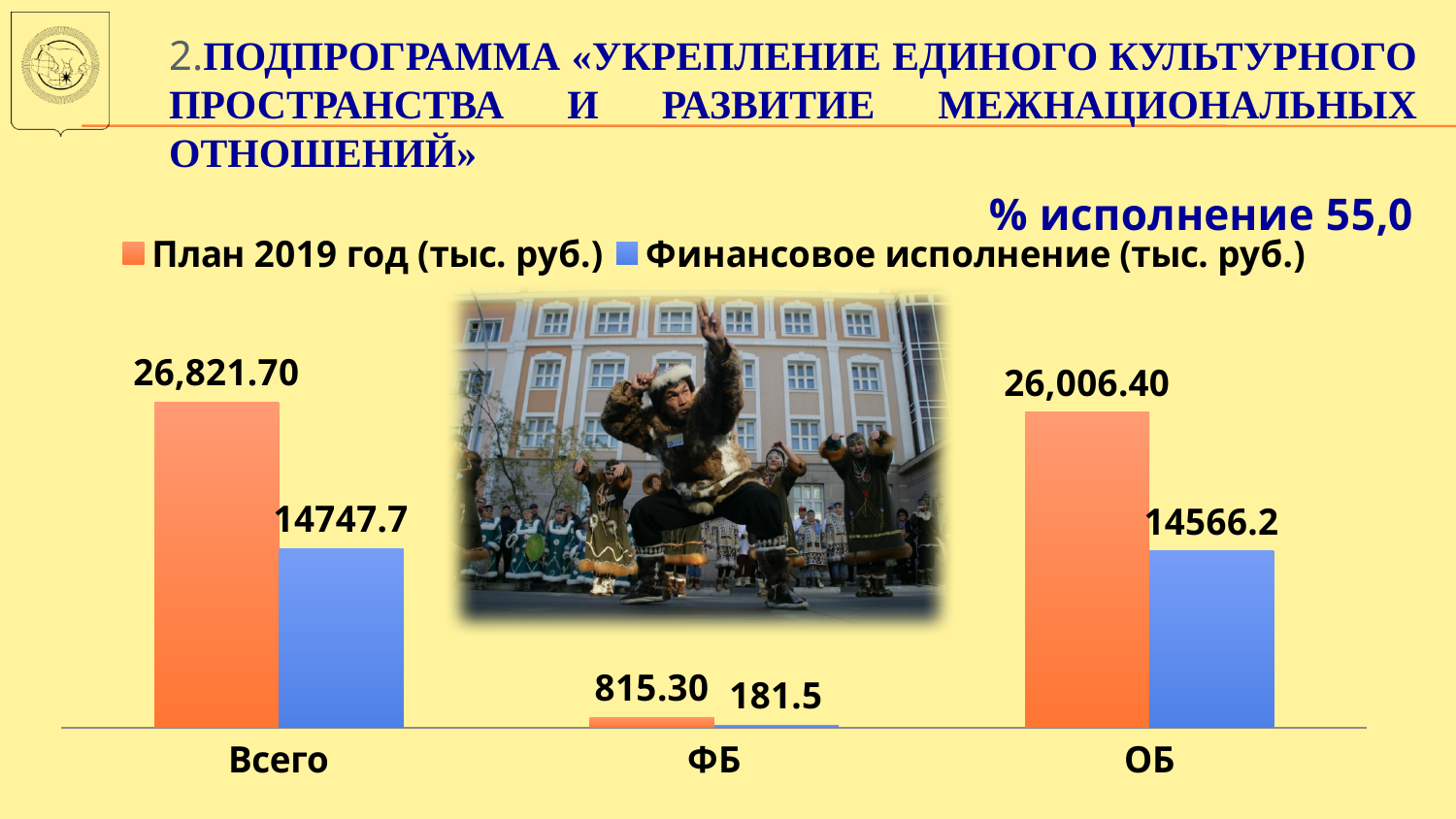
What is the Финансовое исполнение (тыс. руб.) value for ФБ? 181.5 What is the План 2019 год (тыс. руб.) value for Всего? 26,821.70 How many series does the chart legend list? 2 What is the difference between the План 2019 год and Финансовое исполнение values for ФБ? 633.8 What is the Финансовое исполнение (тыс. руб.) value for ОБ? 14566.2 How many categories are shown on the x axis of the chart? 3 What is the difference between the План 2019 год and Финансовое исполнение values for ОБ? 11440.2 Which is larger for Всего: the План 2019 год value or the Финансовое исполнение value? План 2019 год Which category has the highest План 2019 год (тыс. руб.) value? Всего What kind of chart is shown on the slide? Bar chart What is the План 2019 год (тыс. руб.) value for ФБ? 815.30 Which category has the lowest Финансовое исполнение (тыс. руб.) value? ФБ